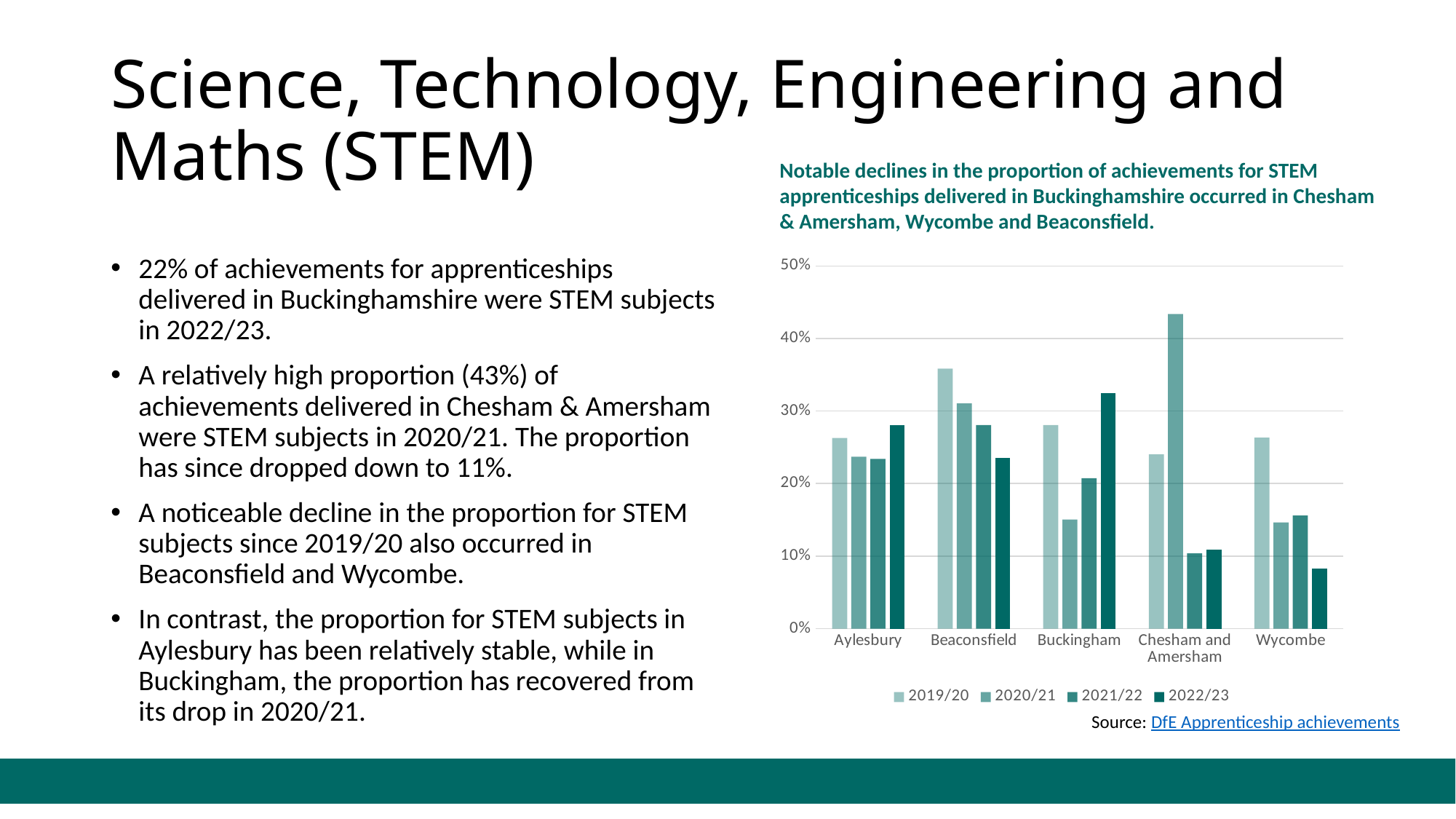
Which area and year has the tallest bar in the chart? Chesham and Amersham, 2020/21 Is the value for Chesham and Amersham in 2020/21 greater or less than 40%? greater What kind of chart is shown on the slide? Bar chart Which area and year has the shortest bar in the chart? Wycombe, 2022/23 Do the values for Wycombe rise or fall from 2019/20 to 2022/23? Fall How many series does the chart legend list? 4 Which year is shown by the darkest bars in the chart legend? 2022/23 How many areas (categories) are shown on the x axis of the chart? 5 Which is larger in 2019/20: the value for Beaconsfield or the value for Aylesbury? Beaconsfield Is the value for Wycombe in 2022/23 greater or less than 10%? less Is the value for Buckingham in 2020/21 greater or less than 20%? less